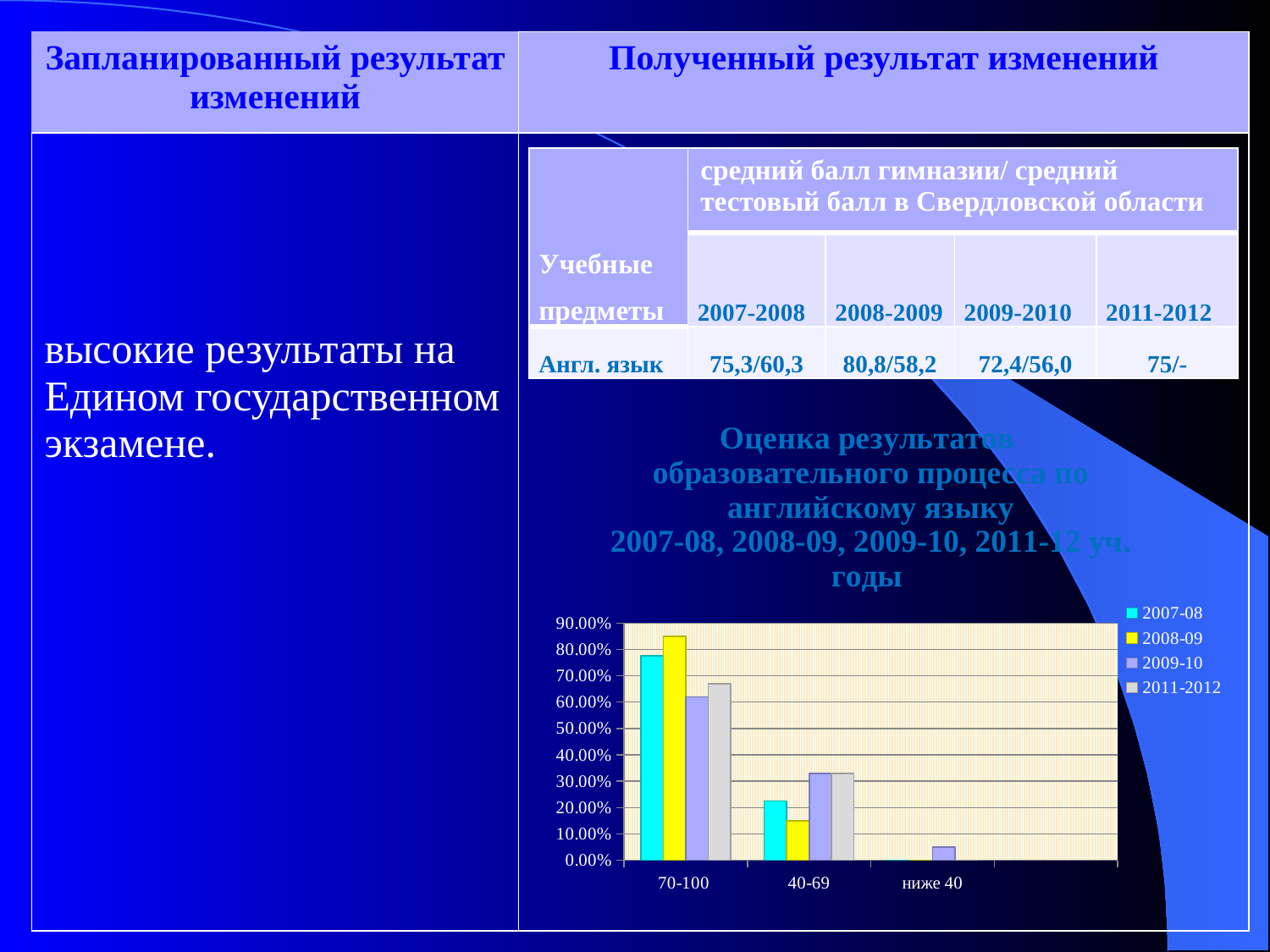
Is the value for 2009-10 in the 70-100 category greater or less than 70.00%? less Which category has the highest value for the 2008-09 series? 70-100 Is the value for 2011-2012 in the 40-69 category greater or less than 30.00%? greater Which category has the lowest value for the 2009-10 series? ниже 40 Which series is shown in yellow in the chart legend? 2008-09 Is the value for 2008-09 in the 40-69 category greater or less than 20.00%? less How many series does the chart legend list? 4 What kind of chart is shown on the slide? bar chart In the 40-69 category, which series has the larger value: 2007-08 or 2008-09? 2007-08 In the 70-100 category, which series has the larger value: 2007-08 or 2009-10? 2007-08 How many categories are shown on the x axis of the chart? 3